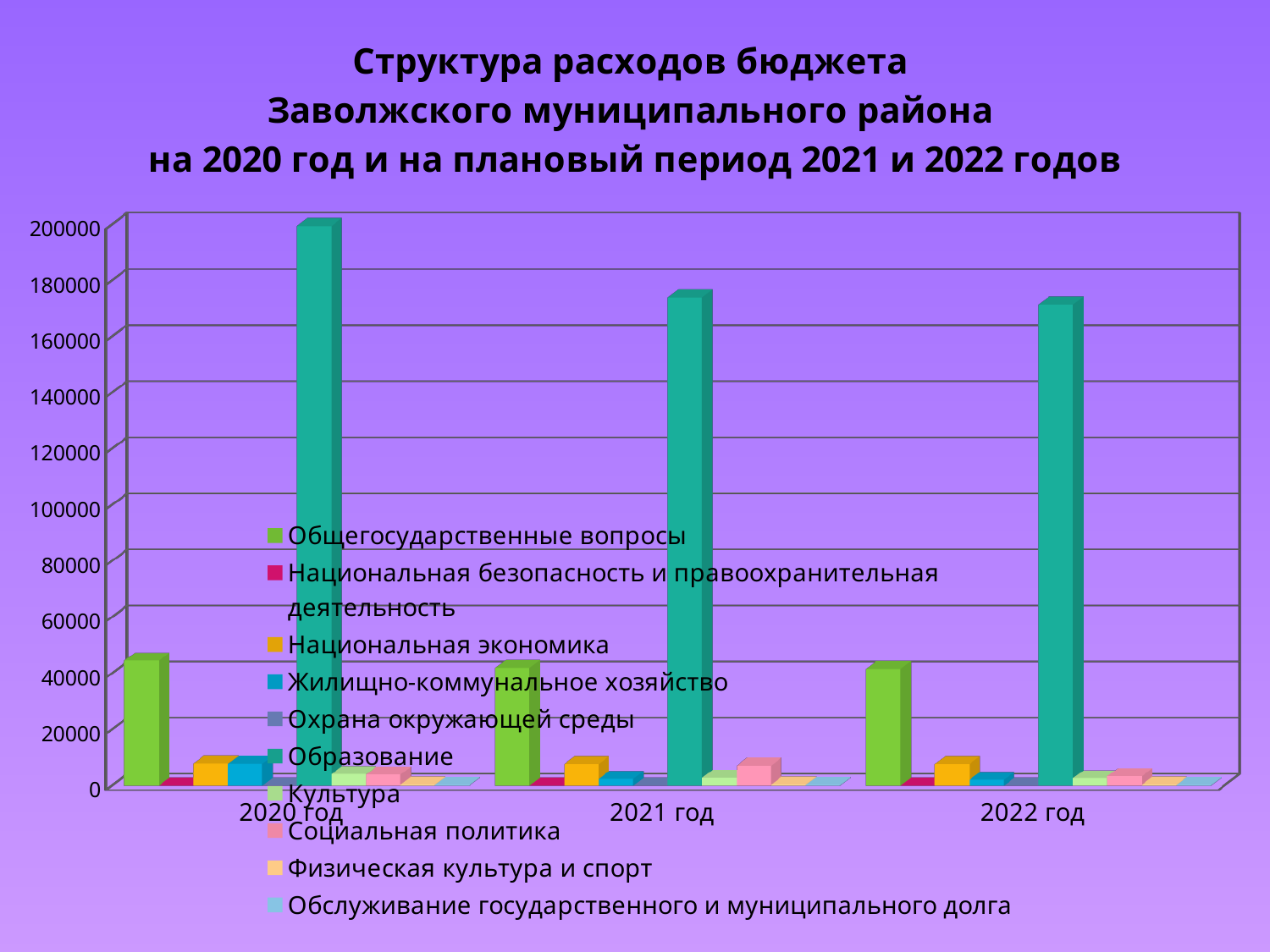
Which series is shown in green in the legend? Общегосударственные вопросы What kind of chart is shown on the slide? bar chart Does the value for Образование rise or fall from 2020 год to 2022 год? fall Which is larger in 2020 год: Общегосударственные вопросы or Национальная экономика? Общегосударственные вопросы Is the value for Образование in 2020 год greater or less than 180000? greater Which is larger: Образование in 2020 год or Образование in 2022 год? 2020 год How many year categories are shown on the x axis? 3 How many series does the legend list? 10 Is the value for Образование in 2022 год greater or less than 180000? less Is the value for Образование in 2021 год greater or less than 160000? greater Which series has the highest value in 2020 год? Образование